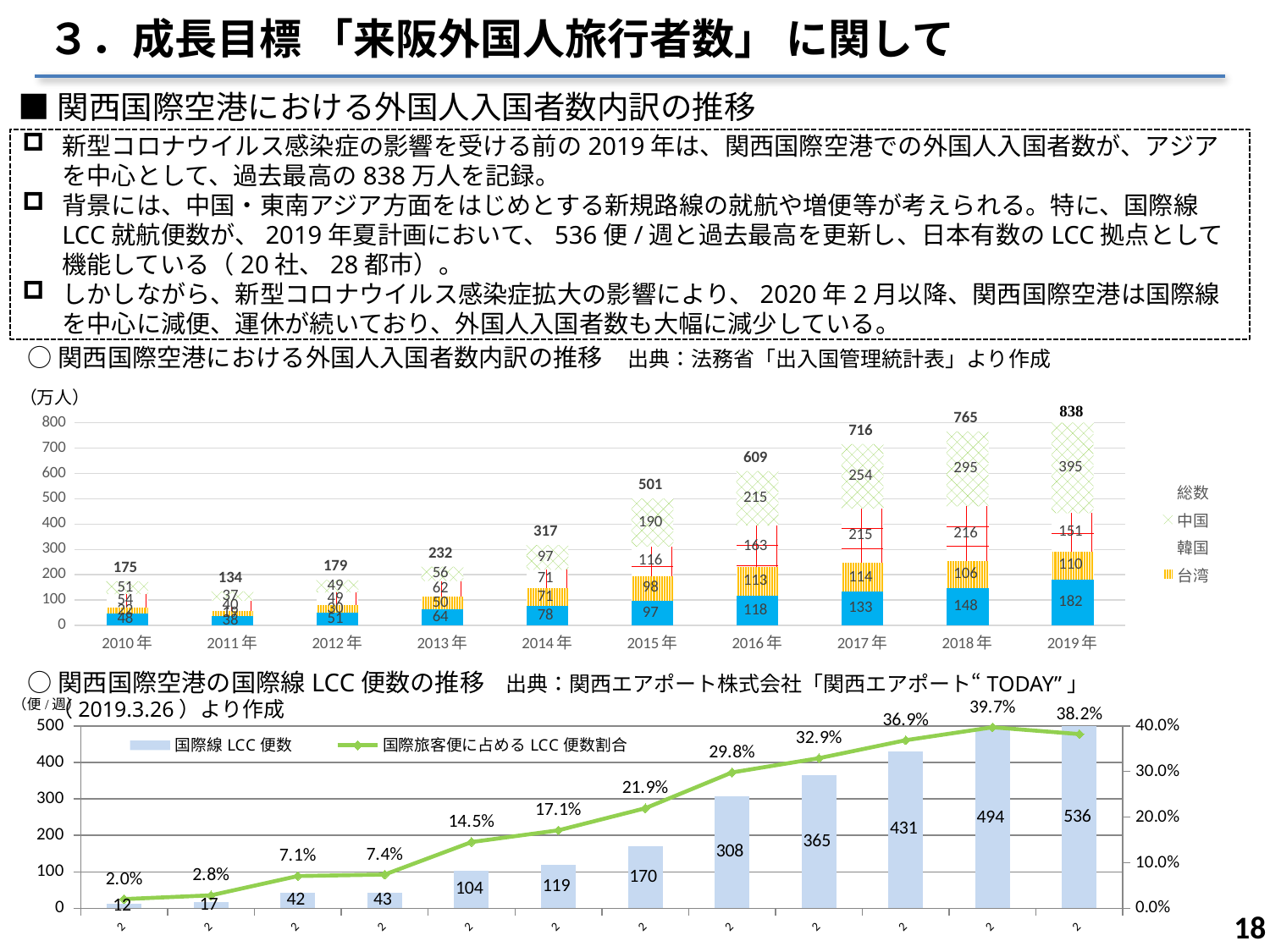
In the bottom chart, what is the lowest 国際線LCC便数 value shown? 12 In the top chart, which year has the lowest total (総数)? 2011年 In the top chart (関西国際空港における外国人入国者数内訳の推移), what is the total (総数) value for 2019年? 838 In the top chart, how many years are shown on the x axis? 10 In the top chart, do the total values generally rise or fall from 2012年 to 2019年? rise In the top chart, what is the difference between the total for 2019年 and the total for 2018年? 73 In the bottom chart, what is the highest 国際旅客便に占めるLCC便数割合 value shown? 39.7% In the bottom chart (関西国際空港の国際線LCC便数の推移), what is the highest 国際線LCC便数 value shown? 536 In the bottom chart, how many series does the legend list? 2 In the top chart, which is larger, the 中国 value for 2016年 or the 中国 value for 2015年? 2016年 In the top chart, what is the 台湾 value for 2017年? 114 In the top chart, what is the 中国 value for 2018年? 295